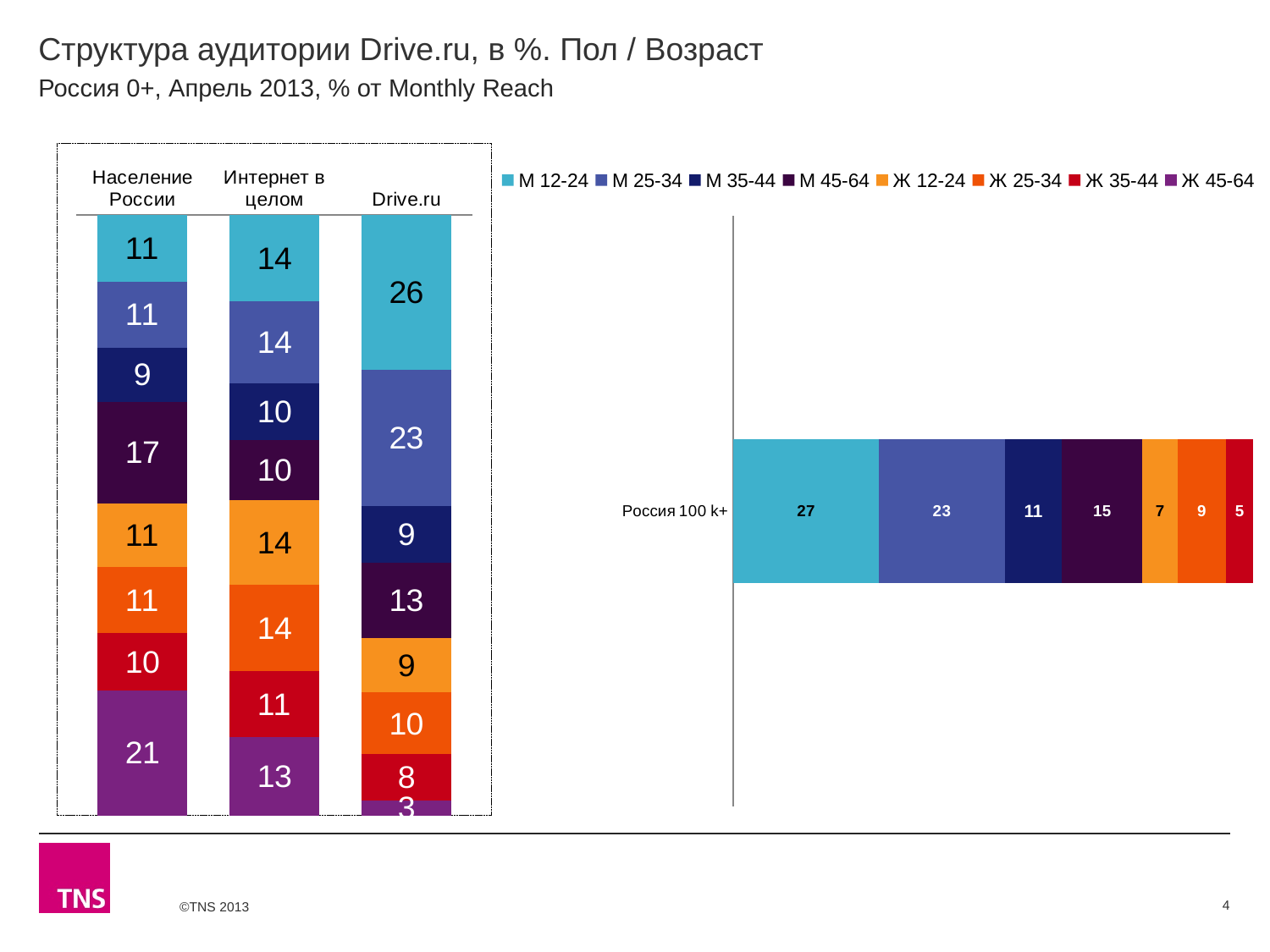
In the right chart (Россия 100 k+), what is the value of the Ж 35-44 segment? 5 How many series does the legend on the slide list? 8 What is the category label of the single bar in the right chart? Россия 100 k+ In the left chart, what is the total of the stacked bar for Интернет в целом? 100 In the left chart, what is the value of the Ж 45-64 segment for Население России? 21 In the right chart (Россия 100 k+), which is larger: the М 45-64 segment or the Ж 12-24 segment? М 45-64 How many categories (bars) does the left chart show? 3 What kind of chart is the right chart (Россия 100 k+)? Stacked bar chart In the left chart, what is the value of the М 12-24 segment for Drive.ru? 26 In the left chart, which of the three bars has the largest М 12-24 segment? Drive.ru In the right chart (Россия 100 k+), what is the value of the М 25-34 segment? 23 In the left chart, what is the difference between the М 12-24 value for Drive.ru and the М 12-24 value for Население России? 15